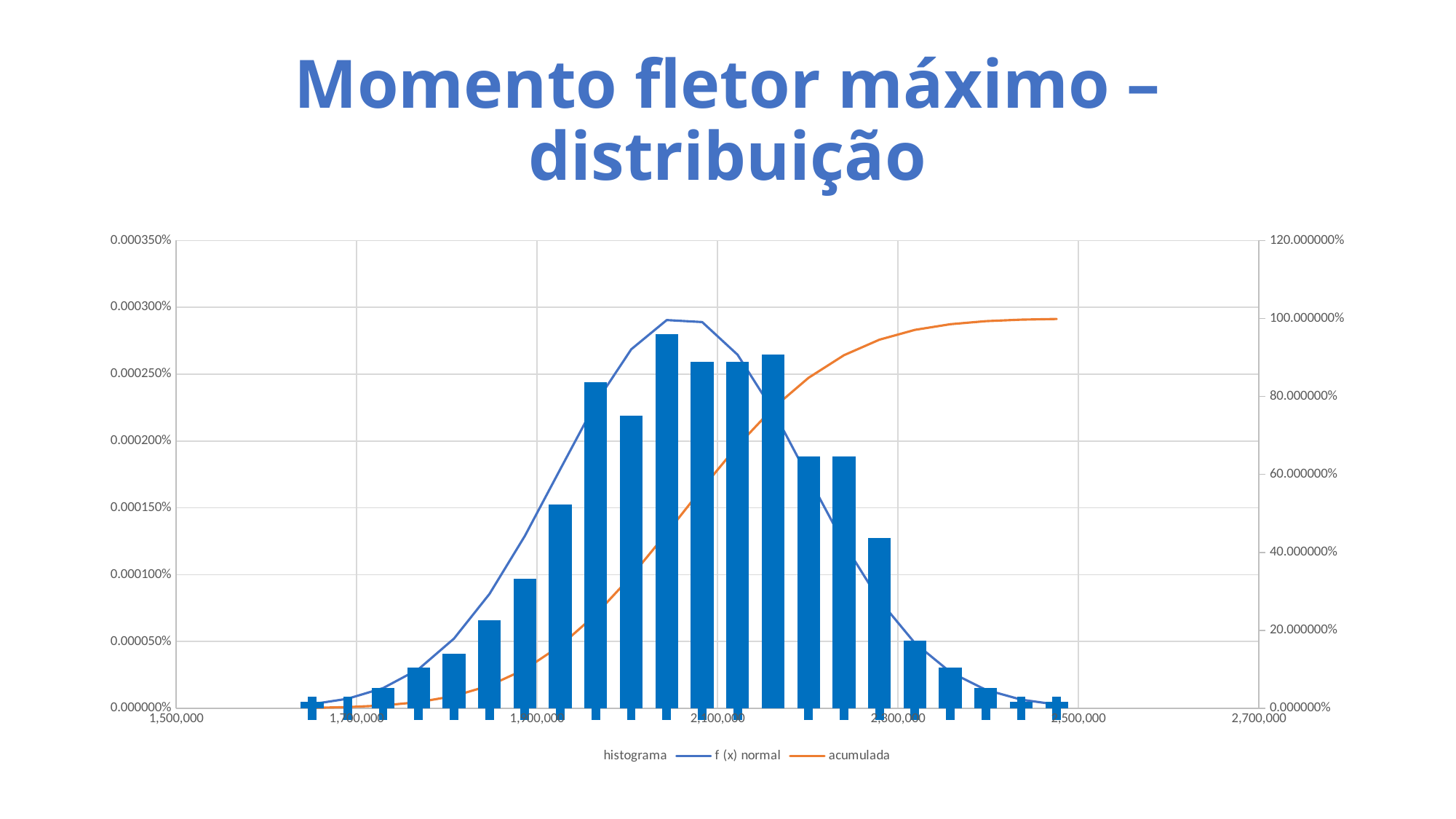
What kind of chart is shown on the slide? A combination of a bar chart (histogram) and line charts What is the title of the slide containing the chart? Momento fletor máximo – distribuição What is the maximum value shown on the left vertical axis? 0.000350% How many series does the legend list? 3 Is the value of the 'acumulada' line at 2,300,000 greater or less than 80.000000%? greater Does the 'acumulada' line rise or fall as the x-axis values increase? Rises What is the highest value labelled on the x axis? 2,700,000 Is the value of the 'acumulada' line at 1,900,000 greater or less than 40.000000%? less Does the 'f (x) normal' line rise and then fall, or fall and then rise, along the x axis? Rises and then falls Is the value of the tallest histogram bar greater or less than 0.000250%? greater